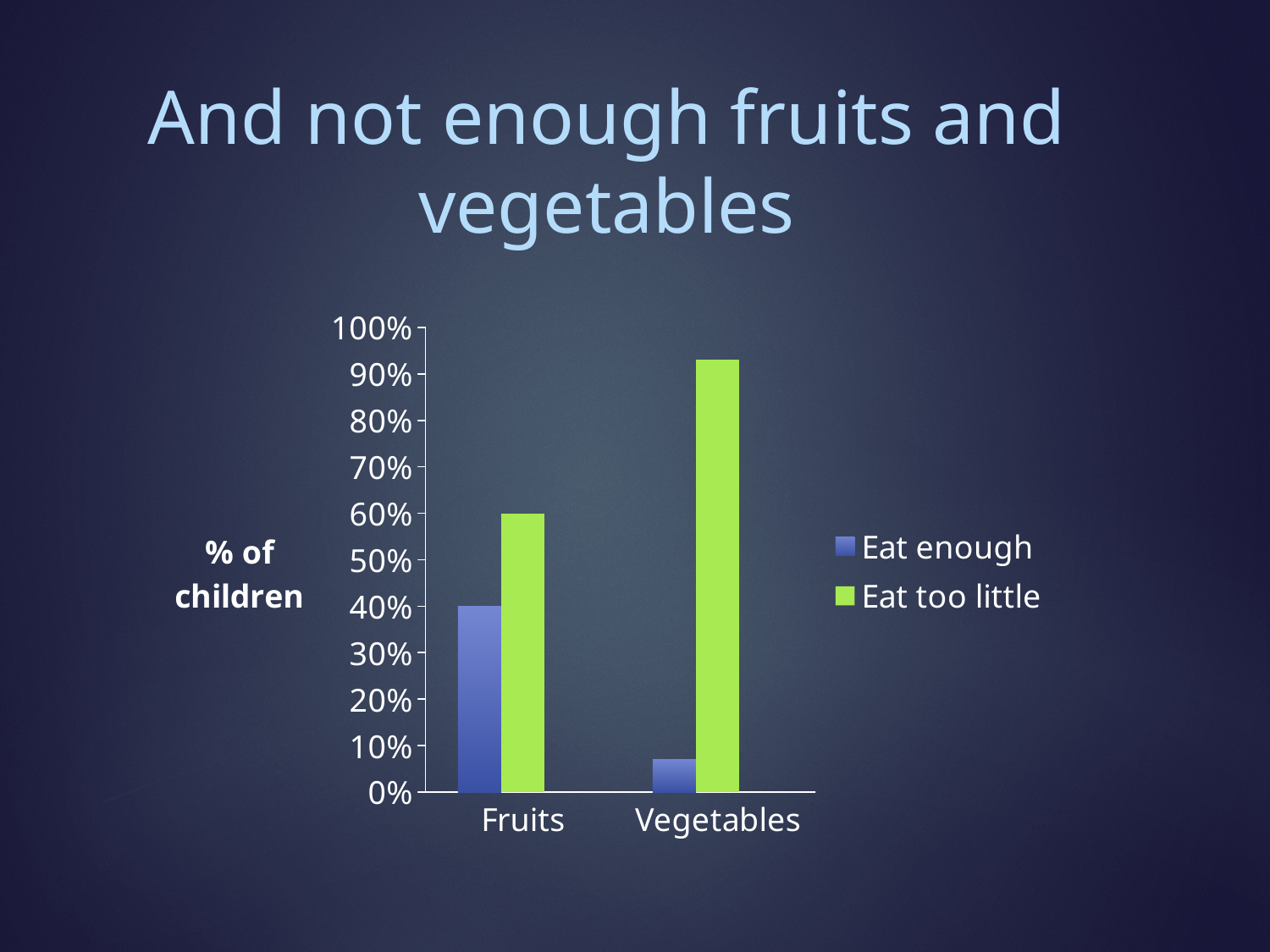
Is the value for Eat enough in the Vegetables category greater or less than 10%? less Which category has the highest value for Eat too little? Vegetables What kind of chart is shown on the slide? bar chart Is the value for Eat too little in the Vegetables category greater or less than 90%? greater What is the value for Eat too little in the Fruits category? 60% In the Fruits category, which is larger: Eat enough or Eat too little? Eat too little What are the two series listed in the chart's legend? Eat enough, Eat too little How many categories are shown on the x axis of the chart? 2 Which category has the lowest value for Eat enough? Vegetables What is the value for Eat enough in the Fruits category? 40% What is the label on the vertical axis of the chart? % of children How many series does the chart's legend list? 2